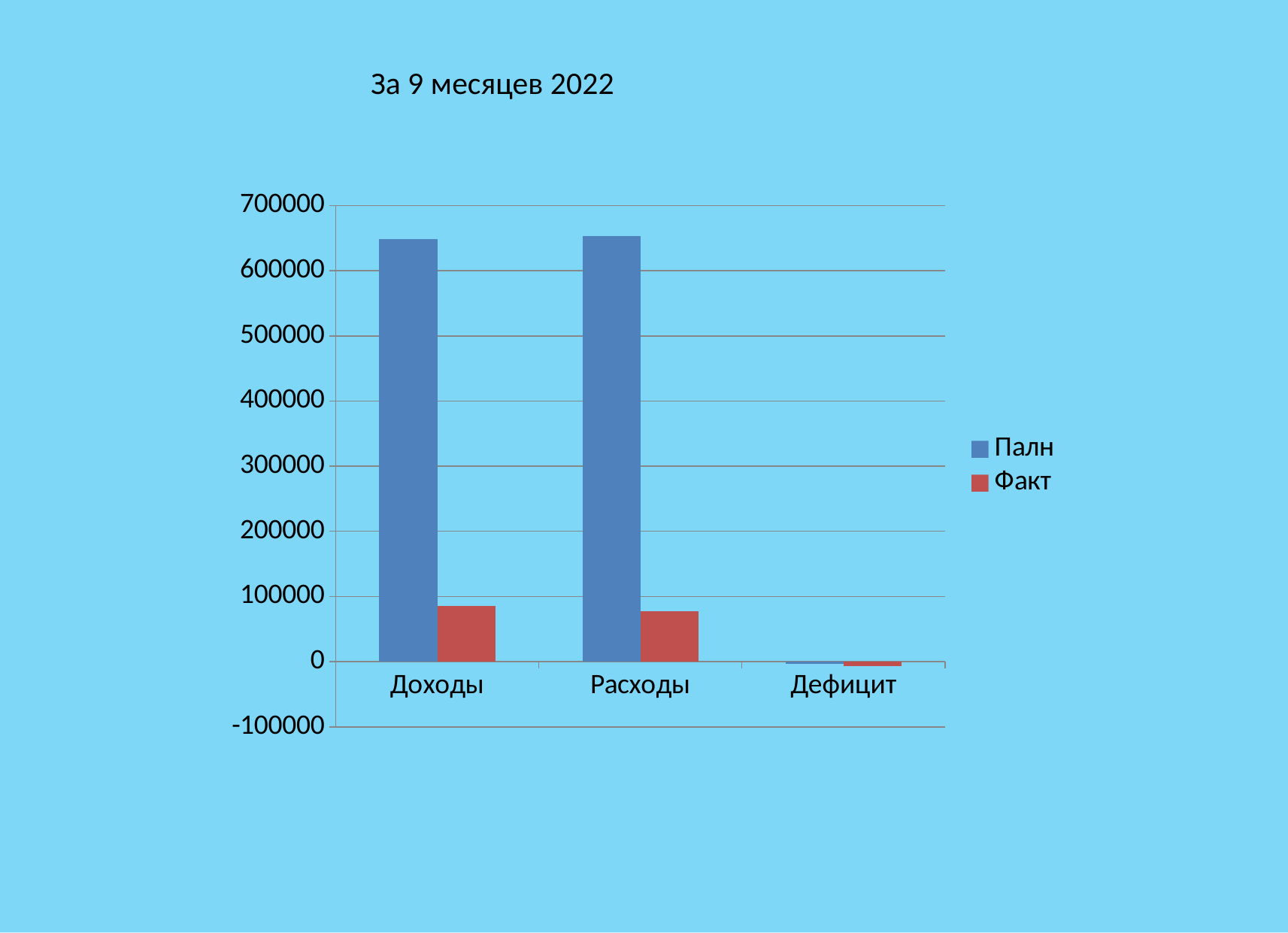
For Доходы, which series has the larger value, Палн or Факт? Палн Which category has the lowest Палн value? Дефицит Is the Факт value for Доходы greater or less than 100000? less Is the Факт value for Расходы greater or less than 200000? less Is the Палн value for Доходы greater or less than 600000? greater Which series is shown in red in the legend? Факт How many series does the legend list? 2 Which category has the lowest Факт value? Дефицит How many categories are shown on the x axis? 3 What is the title of the chart? За 9 месяцев 2022 What kind of chart is shown on the slide? bar chart